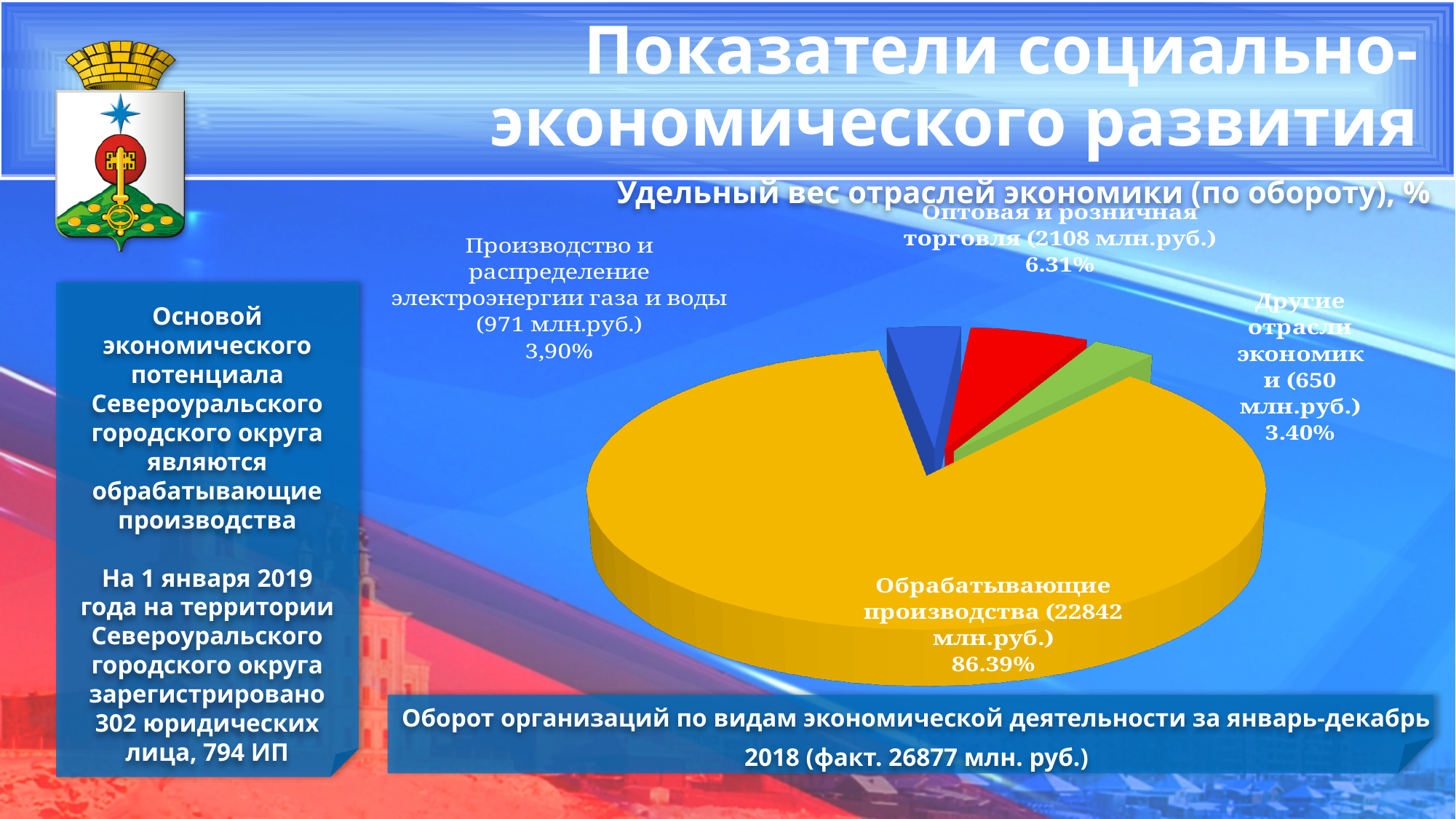
How many slices does the pie chart have? 4 Which sector has the smallest share of the pie? Другие отрасли экономики What share of the pie does Другие отрасли экономики have? 3.40% What turnover value in млн.руб. is shown for Обрабатывающие производства? 22842 млн.руб. Which sector has the largest share of the pie? Обрабатывающие производства What is the difference in percentage points between the shares of Оптовая и розничная торговля and Другие отрасли экономики? 2.91 What share of the pie does Обрабатывающие производства have? 86.39% What kind of chart is shown on the slide? Pie chart What turnover value in млн.руб. is shown for Оптовая и розничная торговля? 2108 млн.руб. What share of the pie does Производство и распределение электроэнергии газа и воды have? 3,90% What is the title of the pie chart? Удельный вес отраслей экономики (по обороту), %